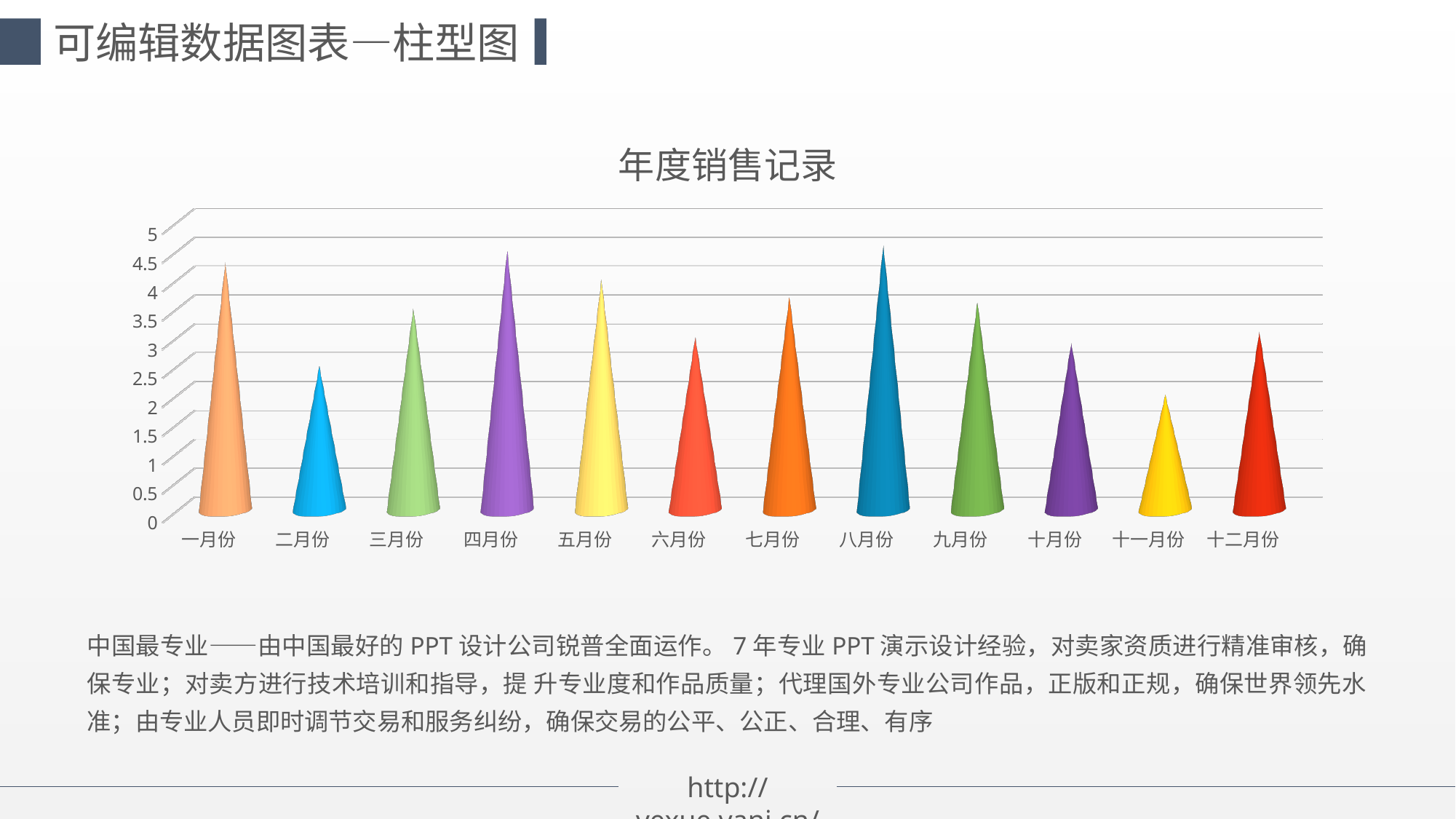
Is the value for 八月份 greater or less than 4? greater Is the value for 十一月份 greater or less than 2.5? less Is the value for 十月份 greater or less than 3.5? less What is the title of the chart? 年度销售记录 How many categories (months) are shown on the x axis of the chart? 12 Which month has the lowest value in the chart? 十一月份 Which is larger, the value for 五月份 or the value for 六月份? 五月份 What kind of chart is shown on the slide? bar chart Which is larger, the value for 一月份 or the value for 二月份? 一月份 Which is larger, the value for 八月份 or the value for 十一月份? 八月份